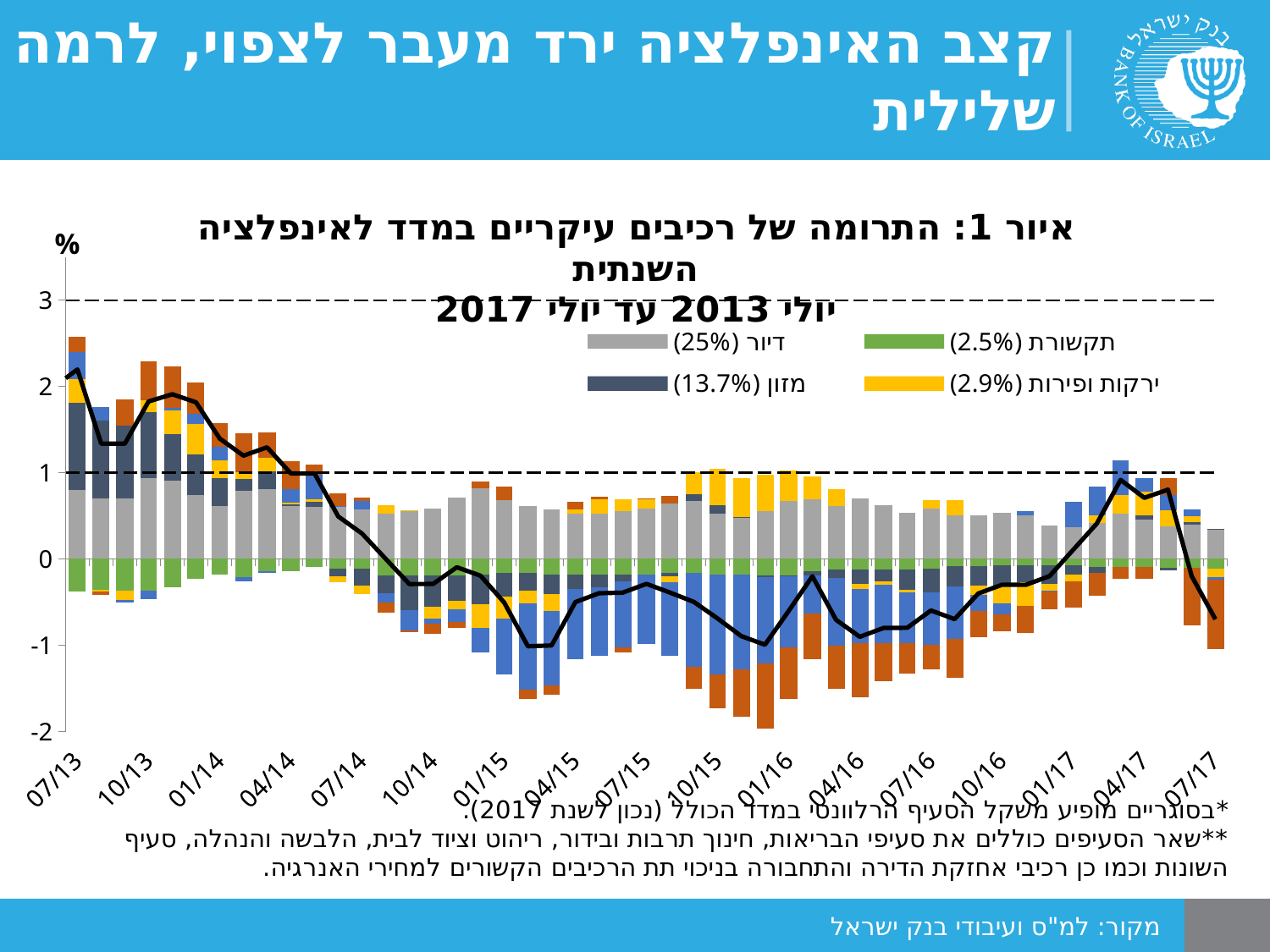
Does the black line rise or fall between 07/13 and 07/14? fall How many series does the visible legend list? 4 Is the value of the black line at 07/17 greater or less than 0? less Is the value of the black line at 10/14 greater or less than 0? less Is the value of the black line at 01/14 greater or less than 1? greater What is the unit shown at the top of the y axis? % According to the legend, what weight is shown for דיור? 25% What kind of chart is shown on the slide? Stacked bar chart with a line At which x-axis date does the black line reach its highest value? 07/13 Which is higher on the black line, 07/13 or 07/17? 07/13